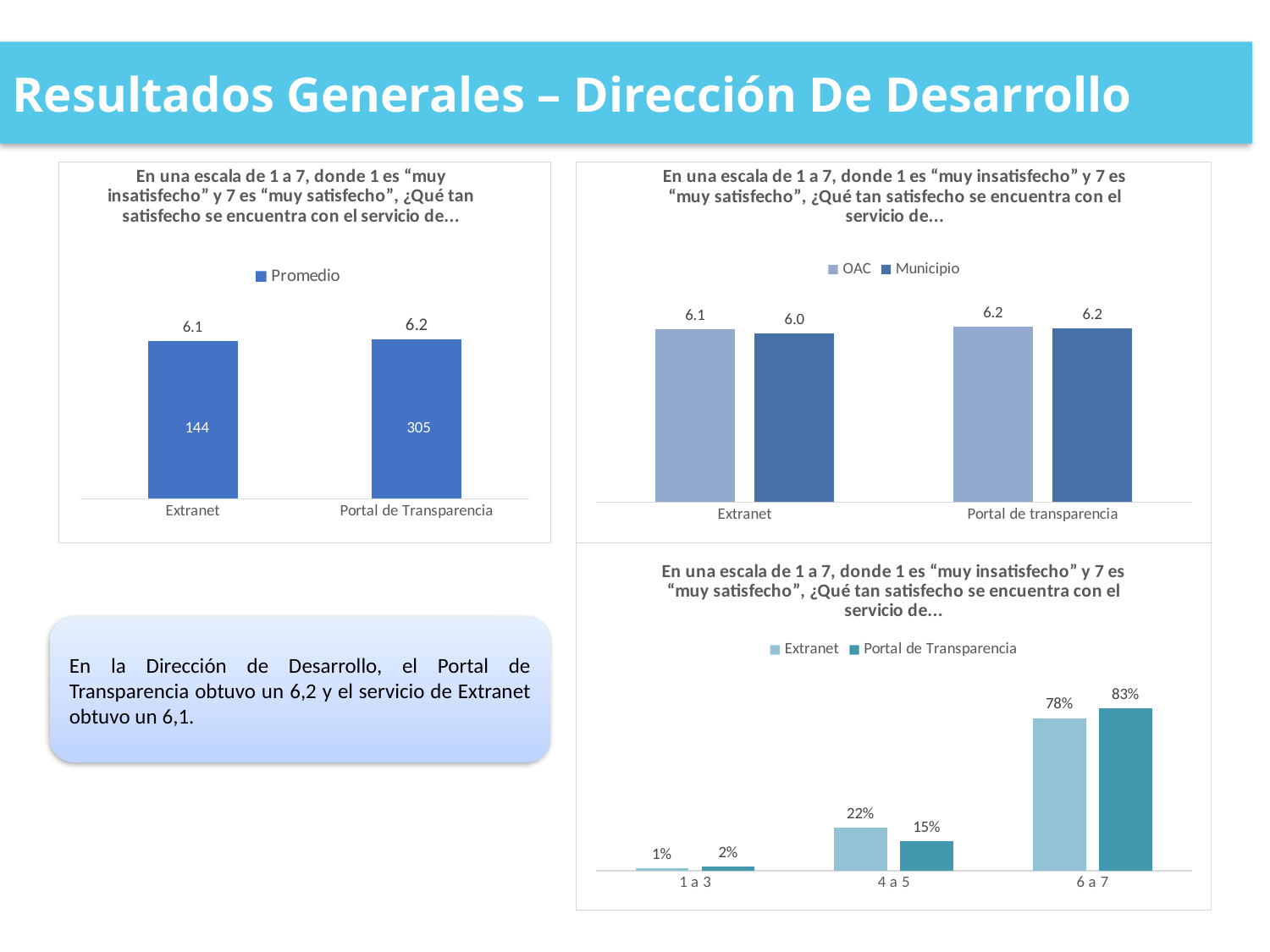
In the bottom-right chart, what percentage of Portal de Transparencia responses fall in the 6 a 7 range? 83% In the top-right chart, what is the OAC value for Portal de transparencia? 6.2 What type of chart is the bottom-right chart? Bar chart In the bottom-right chart, which range has the highest Extranet value? 6 a 7 In the left chart, what number is printed inside the Portal de Transparencia bar? 305 In the top-right chart, how many series does the legend list? 2 In the left chart, how many categories are shown on the x axis? 2 In the bottom-right chart, what is the difference between the Portal de Transparencia and Extranet values for 6 a 7? 5% In the top-right chart, what is the difference between the OAC and Municipio values for Extranet? 0.1 In the top-right chart, what is the Municipio value for Extranet? 6.0 In the bottom-right chart, what is the Extranet value for the 4 a 5 range? 22% In the left chart, what is the average (Promedio) value for Extranet? 6.1